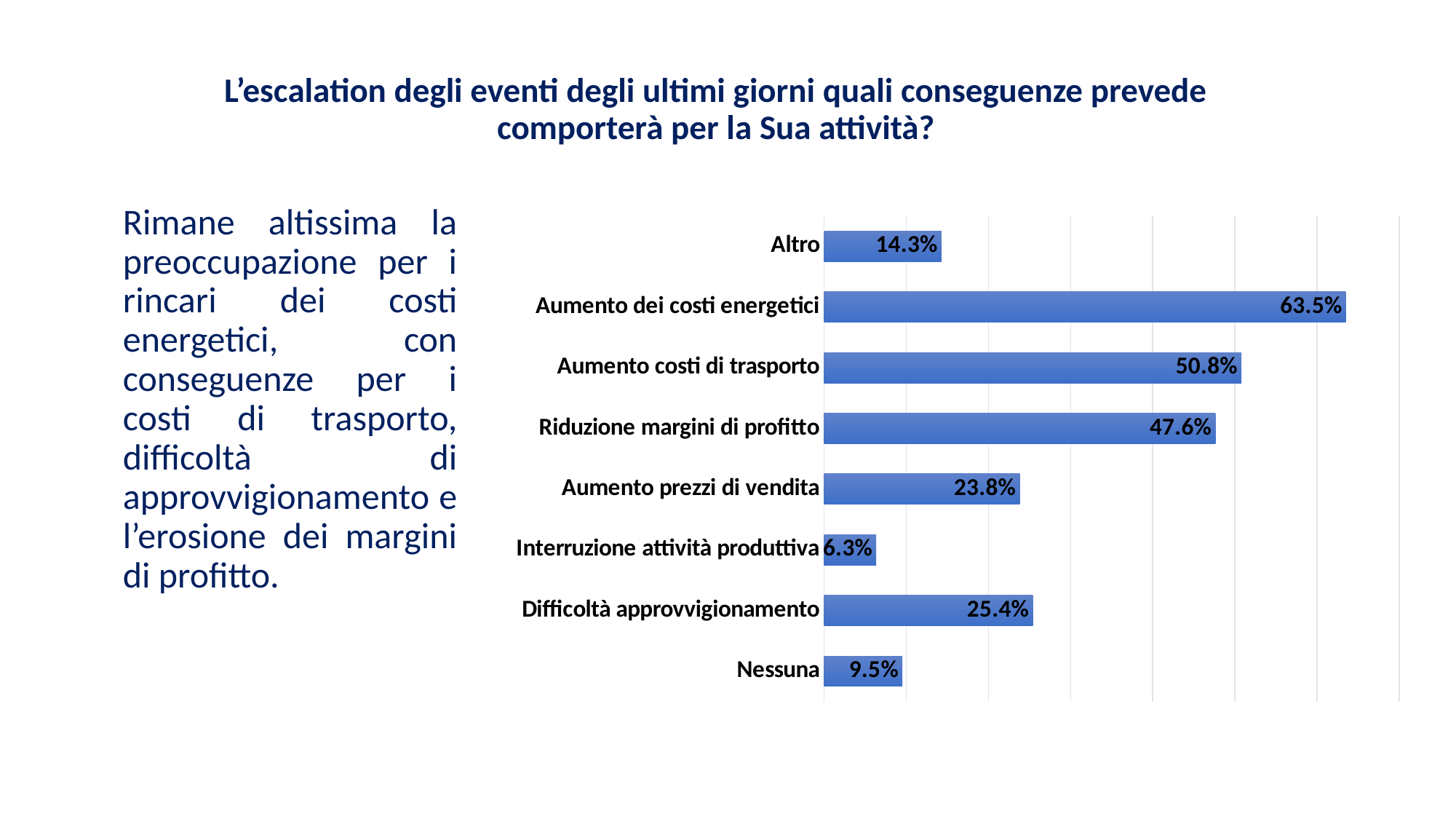
What is the value for "Nessuna"? 9.5% What is the value for "Difficoltà approvvigionamento"? 25.4% What is the value for "Aumento dei costi energetici"? 63.5% What is the difference between "Aumento dei costi energetici" and "Altro"? 49.2% What kind of chart is shown on the slide? Bar chart What is the difference between "Aumento costi di trasporto" and "Riduzione margini di profitto"? 3.2% What is the value for "Interruzione attività produttiva"? 6.3% Which category has the lowest value? Interruzione attività produttiva Which category has the highest value? Aumento dei costi energetici Which is larger, "Aumento prezzi di vendita" or "Difficoltà approvvigionamento"? Difficoltà approvvigionamento How many categories are shown in the chart? 8 Which is larger, "Altro" or "Nessuna"? Altro